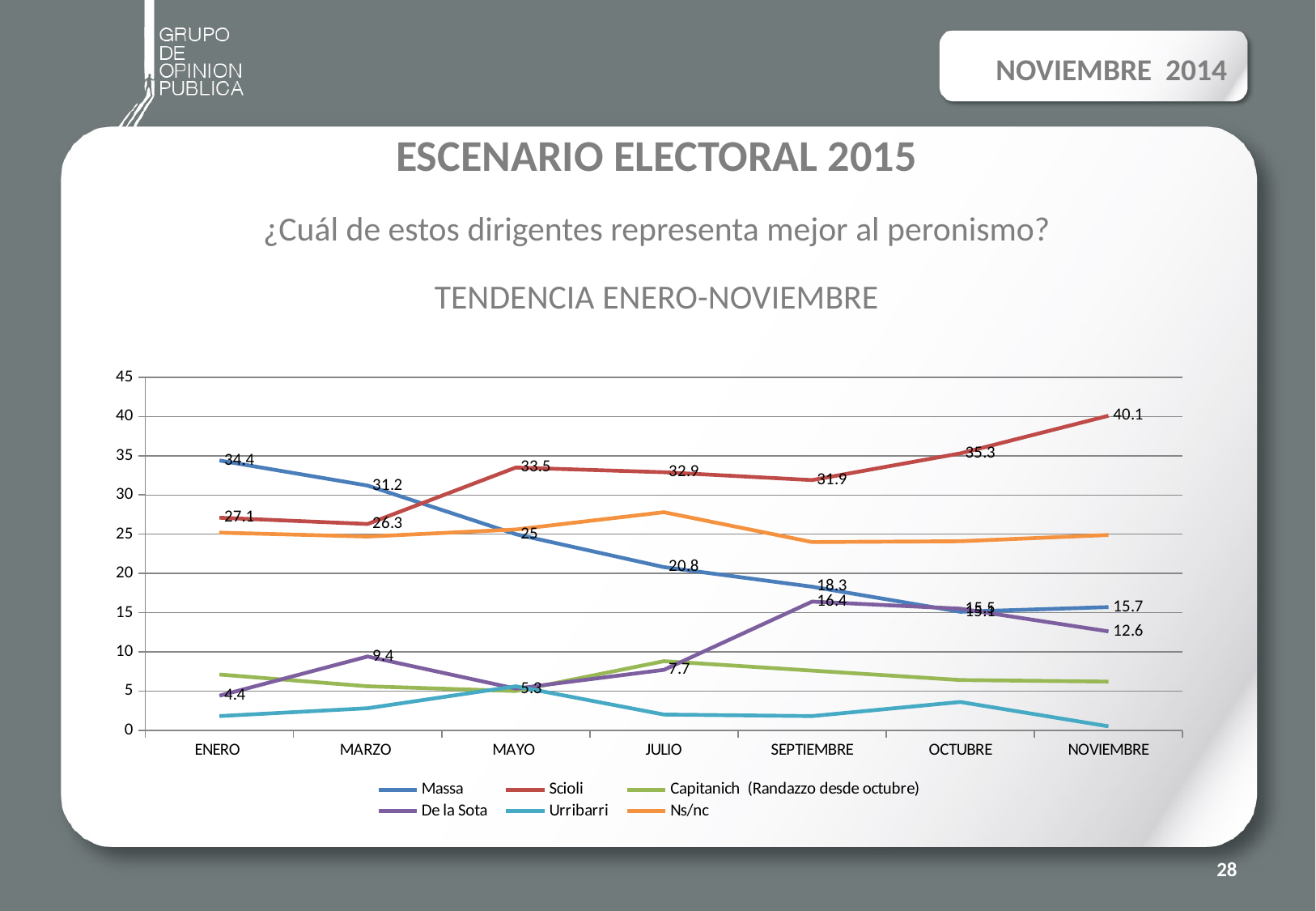
What kind of chart is shown on the slide? line chart What is the value for De la Sota in SEPTIEMBRE? 16.4 Which is larger in ENERO, Massa or Scioli? Massa What is the difference between Scioli and Massa in NOVIEMBRE? 24.4 What is the value for Scioli in NOVIEMBRE? 40.1 How many months are shown along the x axis? 7 Is the value for Urribarri in NOVIEMBRE greater or less than 5? less Does the Massa line rise or fall from ENERO to SEPTIEMBRE? fall How many series does the legend list? 6 Is the value for Ns/nc in JULIO greater or less than 25? greater What is the value for Massa in ENERO? 34.4 In which month does Scioli reach his highest value? NOVIEMBRE